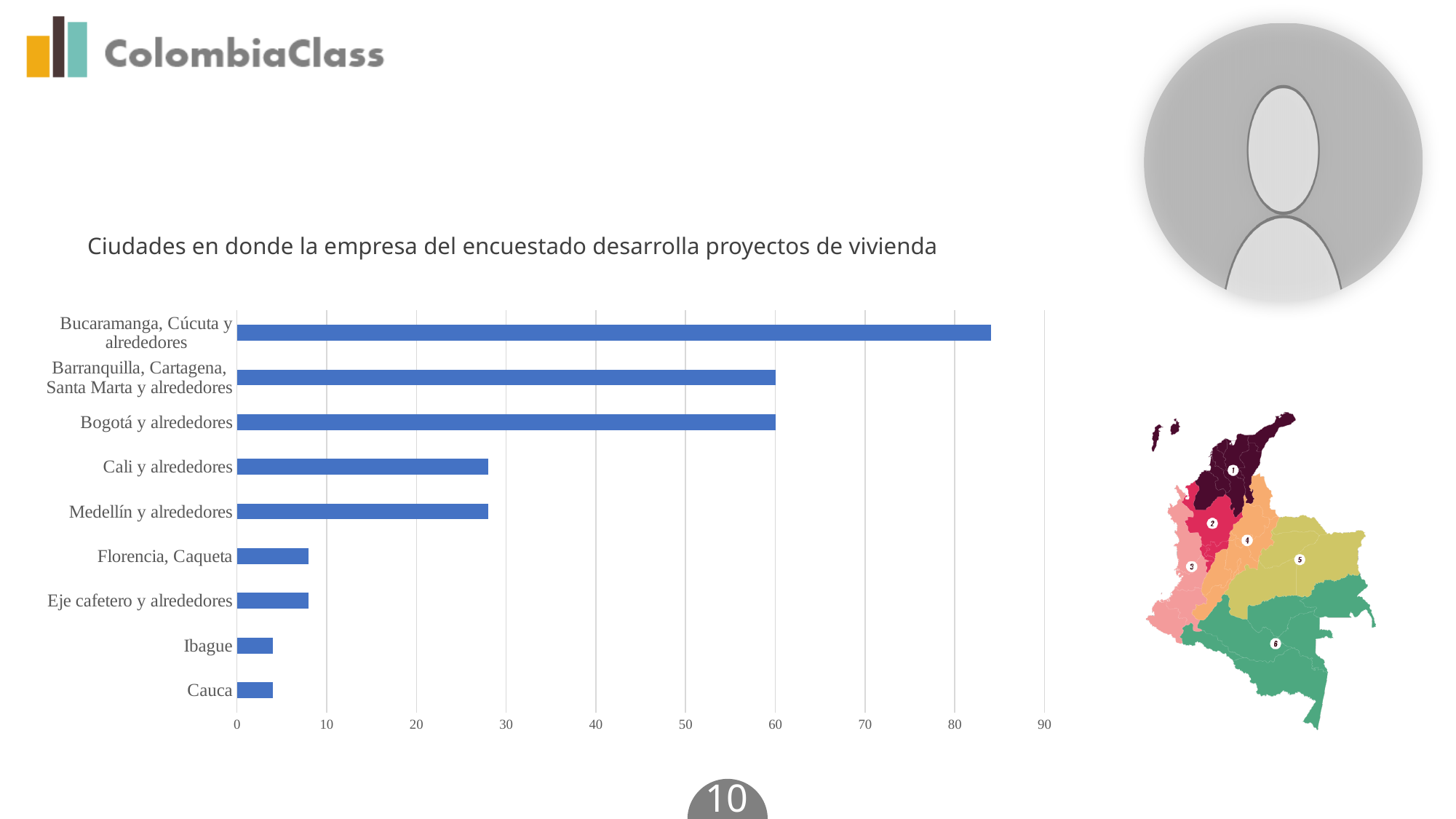
Which category has the highest value in the chart? Bucaramanga, Cúcuta y alrededores What value does the bar for Bogotá y alrededores reach on the axis? 60 Is the value for Cali y alrededores greater or less than 30? less What kind of chart is shown on the slide? bar chart Which is larger, the value for Cali y alrededores or the value for Eje cafetero y alrededores? Cali y alrededores Is the value for Medellín y alrededores greater or less than 20? greater Is the value for Ibague greater or less than 10? less How many categories (city groups) are plotted in the chart? 9 Which is larger, the value for Bucaramanga, Cúcuta y alrededores or the value for Bogotá y alrededores? Bucaramanga, Cúcuta y alrededores What is the title of the chart? Ciudades en donde la empresa del encuestado desarrolla proyectos de vivienda